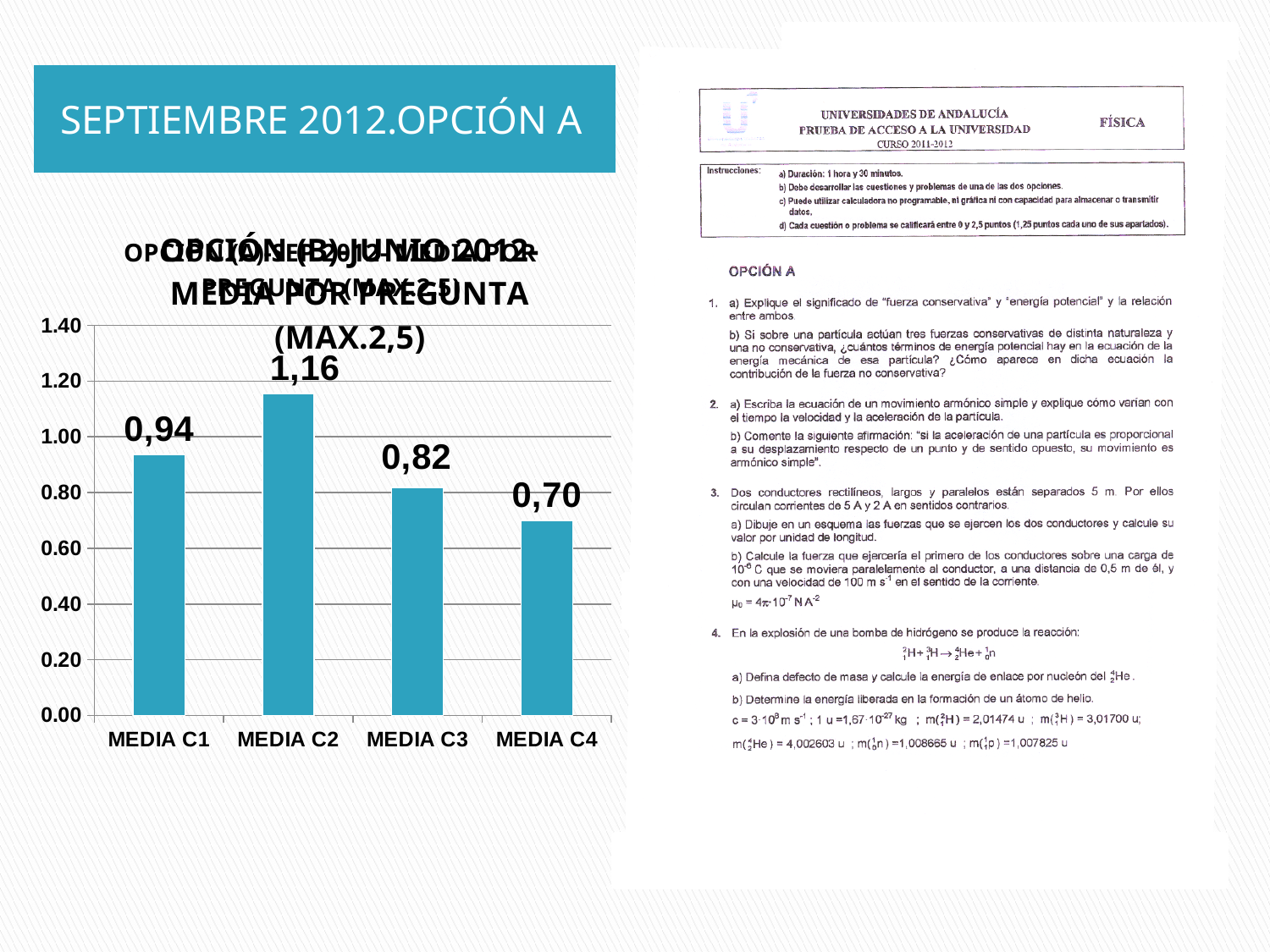
What is the value for MEDIA C1? 0,94 Which is larger, the value for MEDIA C1 or the value for MEDIA C3? MEDIA C1 Which category has the highest value? MEDIA C2 Is the value for MEDIA C2 greater or less than 1.00? greater What is the difference between the values for MEDIA C1 and MEDIA C3? 0,12 What is the value for MEDIA C4? 0,70 What is the difference between the values for MEDIA C2 and MEDIA C4? 0,46 How many categories are shown on the x axis? 4 What is the value for MEDIA C2? 1,16 What is the value for MEDIA C3? 0,82 What kind of chart is shown on the slide? bar chart Which category has the lowest value? MEDIA C4